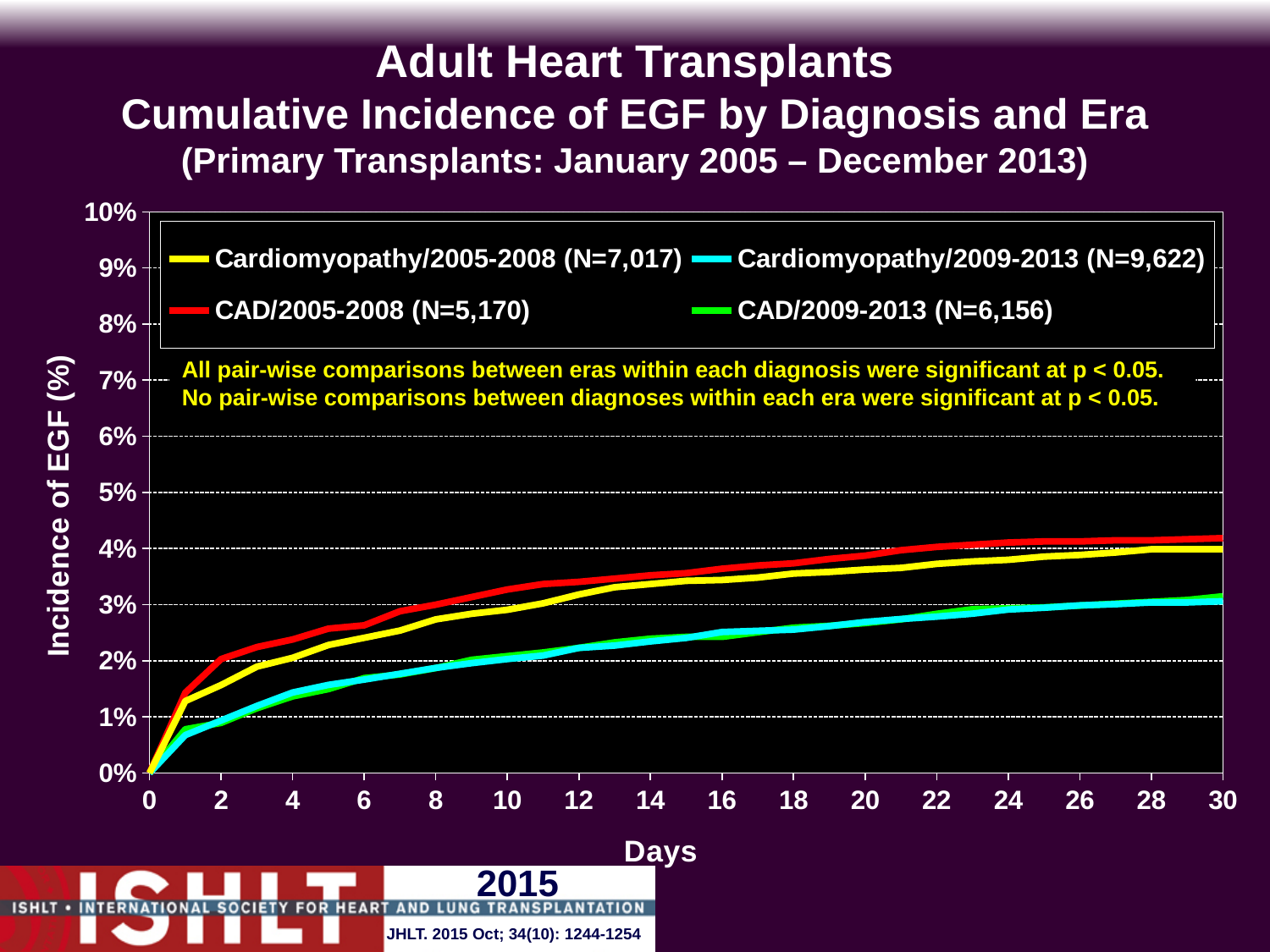
What kind of chart is shown on the slide? line chart What is the label of the x axis? Days What is the label of the y axis? Incidence of EGF (%) Which series has the highest value at day 30? CAD/2005-2008 (N=5,170) Do the values for Cardiomyopathy/2005-2008 rise or fall as days increase from 0 to 30? rise Is the value for CAD/2005-2008 at day 2 greater or less than 1%? greater Is the value for Cardiomyopathy/2009-2013 at day 30 greater or less than 4%? less Is the value for CAD/2009-2013 at day 20 greater or less than 2%? greater At day 30, which series has the higher value: CAD/2005-2008 or Cardiomyopathy/2009-2013? CAD/2005-2008 How many series does the legend list? 4